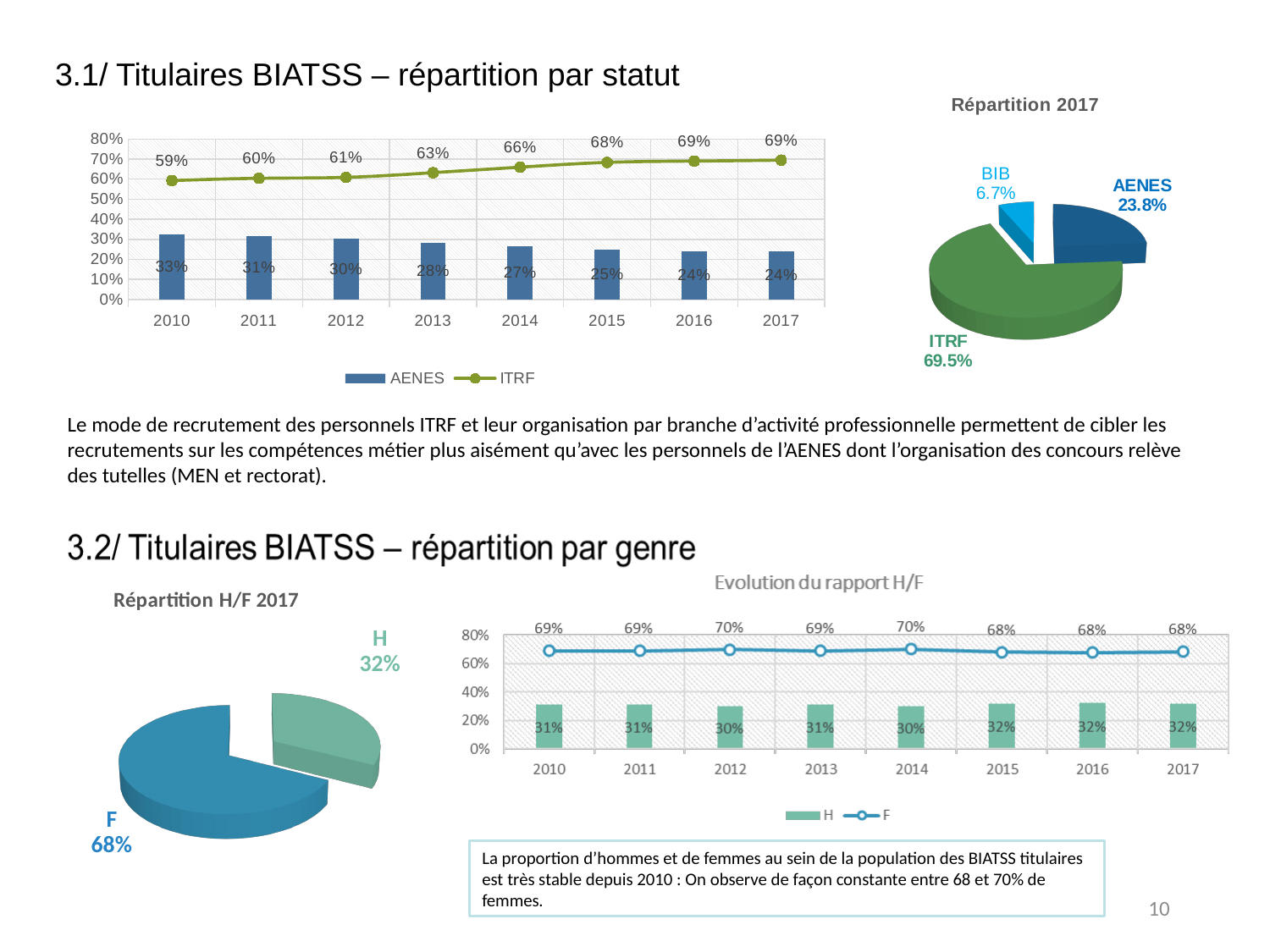
In the top-left chart (AENES/ITRF by year), does the ITRF line rise or fall from 2010 to 2017? rise In the pie chart titled 'Répartition 2017', which category has the smallest slice? BIB In the chart titled 'Evolution du rapport H/F', what is the H value for 2015? 32% In the top-left chart (AENES/ITRF by year), what is the AENES value for 2010? 33% In the top-left chart (AENES/ITRF by year), what is the difference between the ITRF and AENES values in 2017? 45% In the top-left chart (AENES/ITRF by year), what is the ITRF value for 2014? 66% In the chart titled 'Evolution du rapport H/F', which is larger in 2012, the H value or the F value? F In the top-left chart (AENES/ITRF by year), how many years are shown on the x axis? 8 In the top-left chart (AENES/ITRF by year), in which year is the AENES value highest? 2010 In the pie chart titled 'Répartition 2017', what is the share for ITRF? 69.5% In the pie chart titled 'Répartition H/F 2017', what is the share for F? 68% In the chart titled 'Evolution du rapport H/F', how many series does the legend list? 2